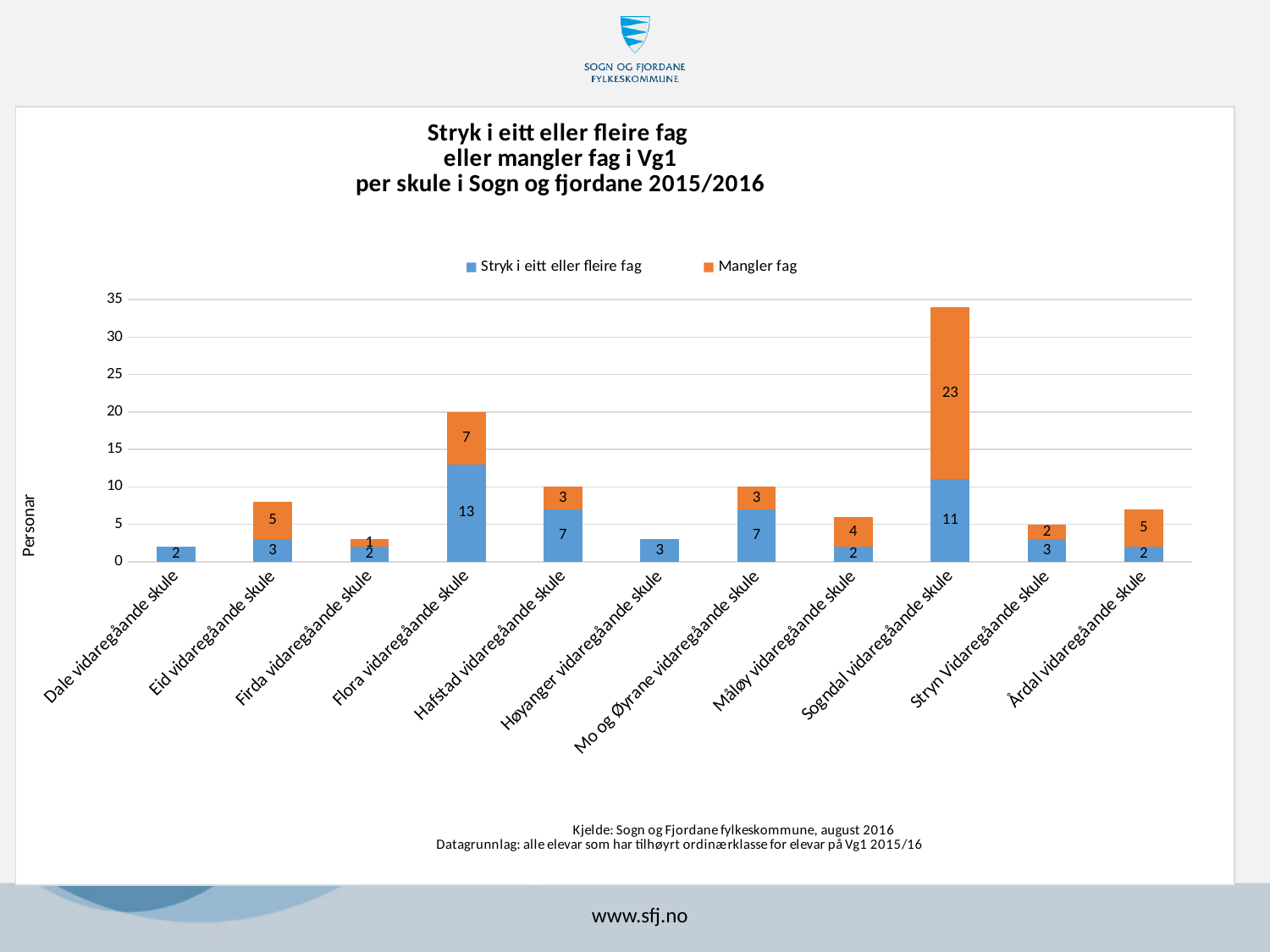
How many series does the legend list? 2 What is the label of the y axis? Personar What is the total of the stacked bar for Flora vidaregåande skule? 20 What is the value of 'Mangler fag' for Sogndal vidaregåande skule? 23 What is the value of 'Stryk i eitt eller fleire fag' for Flora vidaregåande skule? 13 Which is larger: 'Stryk i eitt eller fleire fag' for Hafstad vidaregåande skule or for Eid vidaregåande skule? Hafstad vidaregåande skule What type of chart is shown on the slide? Stacked bar chart What is the total of the stacked bar for Sogndal vidaregåande skule? 34 Which school has the highest 'Mangler fag' value? Sogndal vidaregåande skule How many schools are shown on the x axis? 11 What is the value of 'Mangler fag' for Måløy vidaregåande skule? 4 What is the difference between the 'Mangler fag' values for Sogndal vidaregåande skule and Flora vidaregåande skule? 16